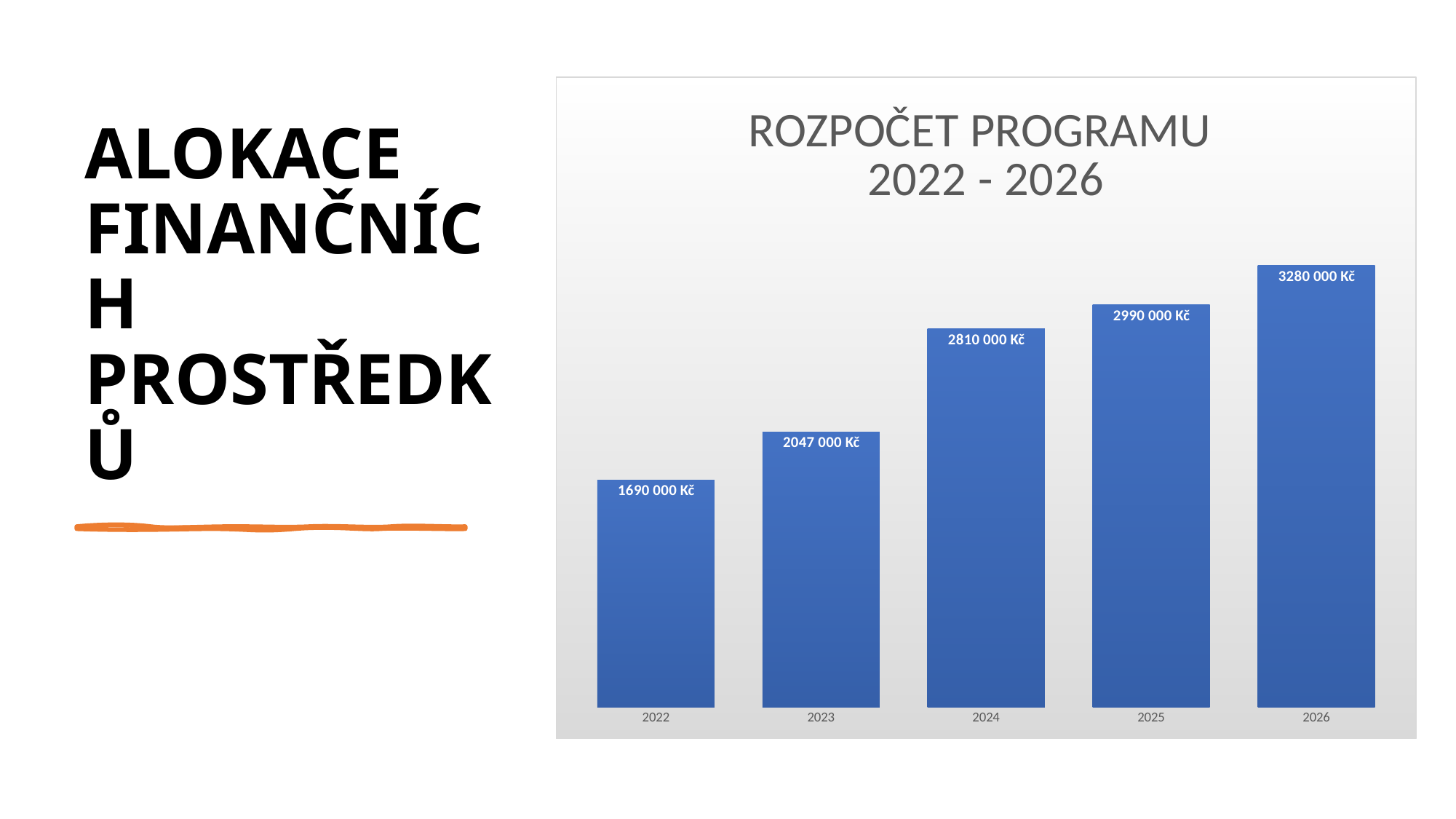
What is the budget value for 2026? 3280 000 Kč Which year has the lowest budget? 2022 What is the budget value for 2022? 1690 000 Kč What is the difference between the budget for 2026 and the budget for 2025? 290 000 Kč What is the difference between the budget for 2023 and the budget for 2022? 357 000 Kč What is the title of the chart? ROZPOČET PROGRAMU 2022 - 2026 How many years are shown on the chart? 5 Which year has the highest budget? 2026 What is the budget value for 2024? 2810 000 Kč Which is larger, the budget for 2024 or the budget for 2025? 2025 Do the budget values rise or fall from 2022 to 2026? Rise What kind of chart is shown on the slide? Bar chart